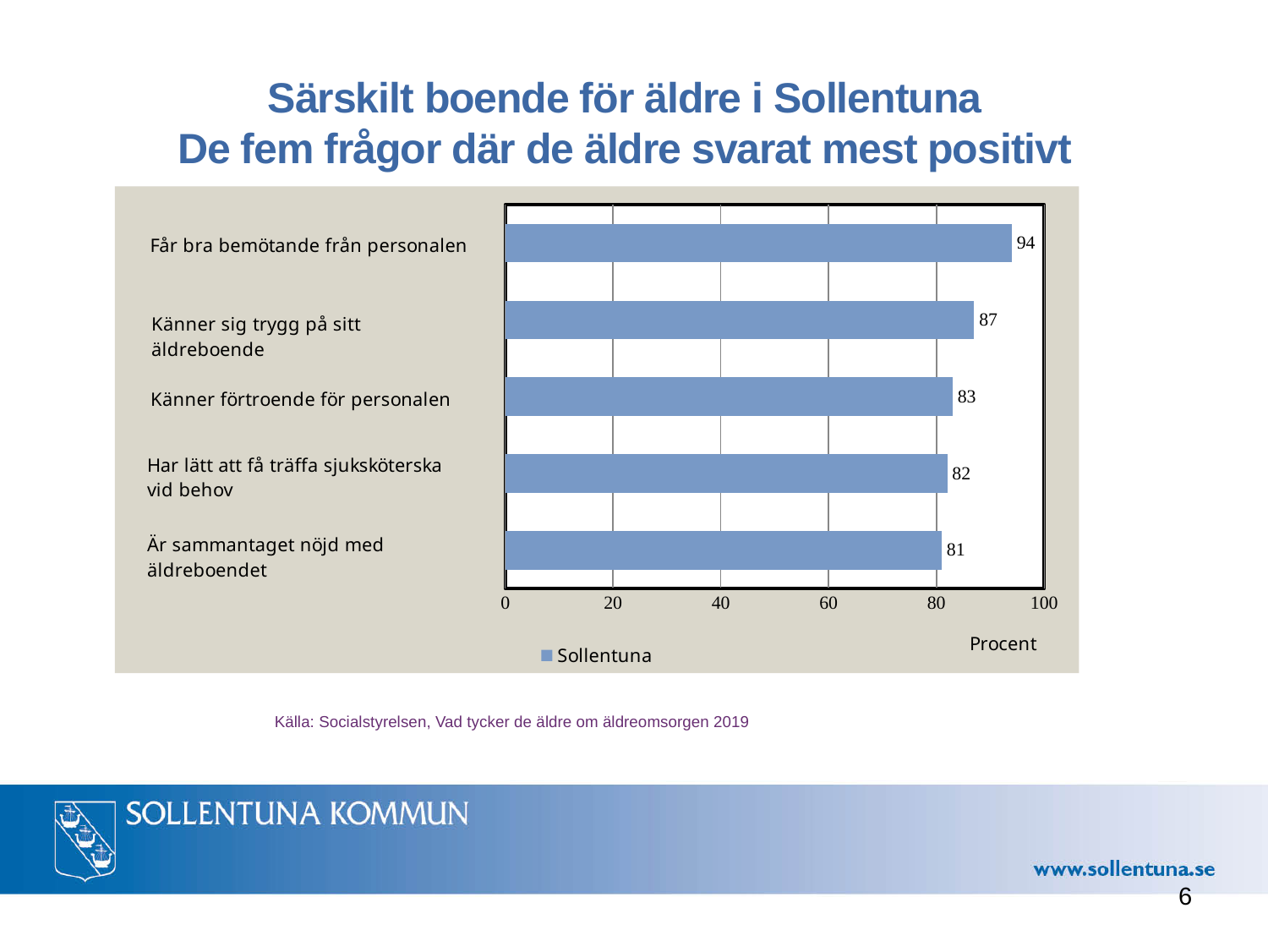
Is the value for "Känner förtroende för personalen" greater or less than 80? greater What is the value for "Får bra bemötande från personalen"? 94 What kind of chart is shown on the slide? bar chart How many series does the legend list? 1 What is the name of the series shown in the legend? Sollentuna Which category has the lowest value? Är sammantaget nöjd med äldreboendet Which is larger: the value for "Känner sig trygg på sitt äldreboende" or the value for "Har lätt att få träffa sjuksköterska vid behov"? Känner sig trygg på sitt äldreboende Which category has the highest value? Får bra bemötande från personalen How many categories are shown in the chart? 5 What is the value for "Är sammantaget nöjd med äldreboendet"? 81 What is the value for "Känner sig trygg på sitt äldreboende"? 87 What is the difference between the values for "Får bra bemötande från personalen" and "Känner förtroende för personalen"? 11